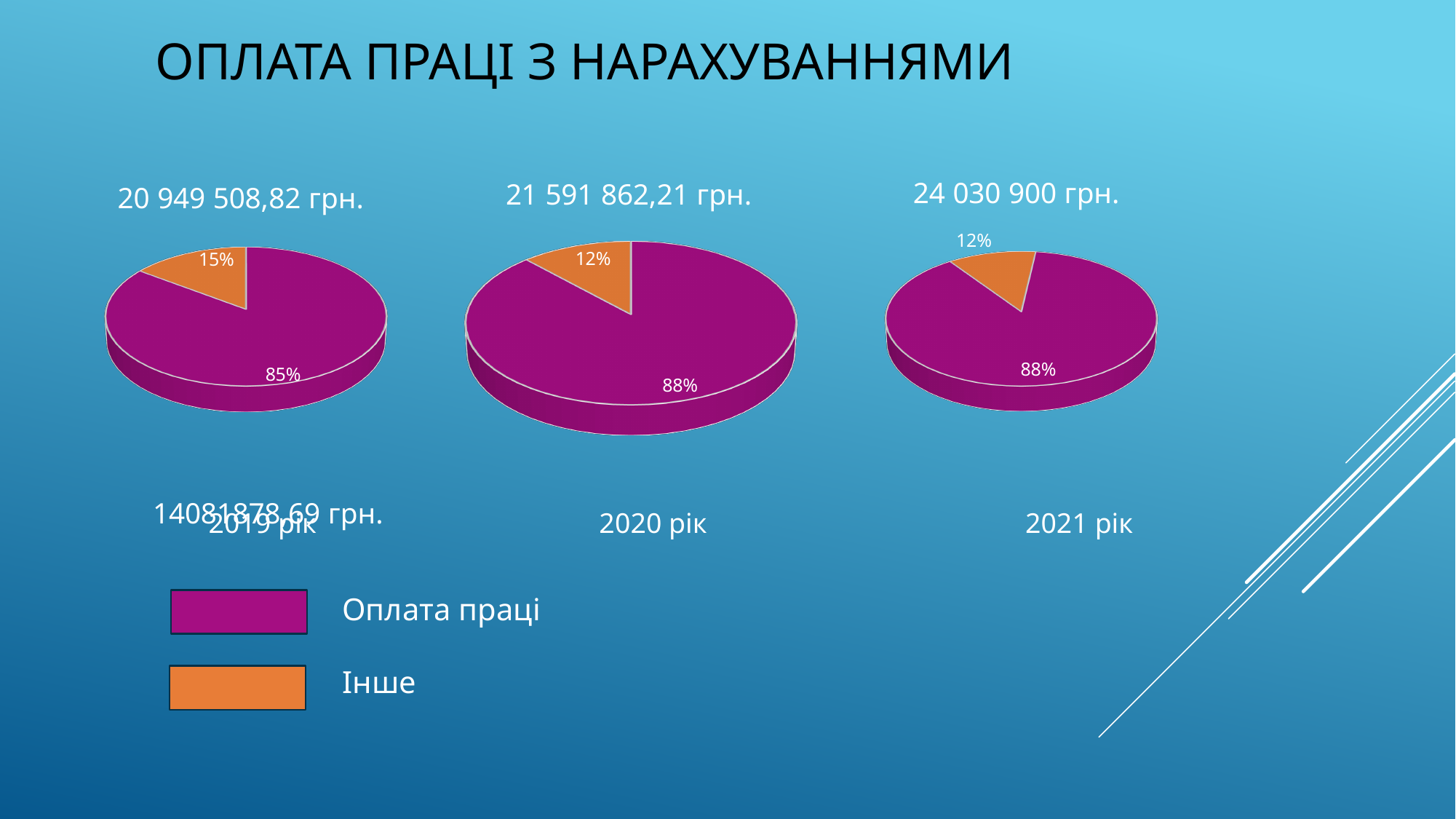
In the 2019 рік pie chart, what share does Оплата праці have? 85% In the 2020 рік pie chart, which slice is the largest? Оплата праці What is the difference between the Оплата праці share in 2020 рік and in 2019 рік? 3% How many entries does the legend list? 2 In the 2021 рік pie chart, which slice is the smallest? Інше Is the Інше share larger in the 2019 рік pie chart or in the 2021 рік pie chart? 2019 рік In the 2021 рік pie chart, what share does Інше have? 12% In the 2020 рік pie chart, what share does Оплата праці have? 88% What kind of chart is used for the 2019 рік data? pie chart How many slices does the 2020 рік pie chart have? 2 What total amount is shown above the 2021 рік pie chart? 24 030 900 грн.